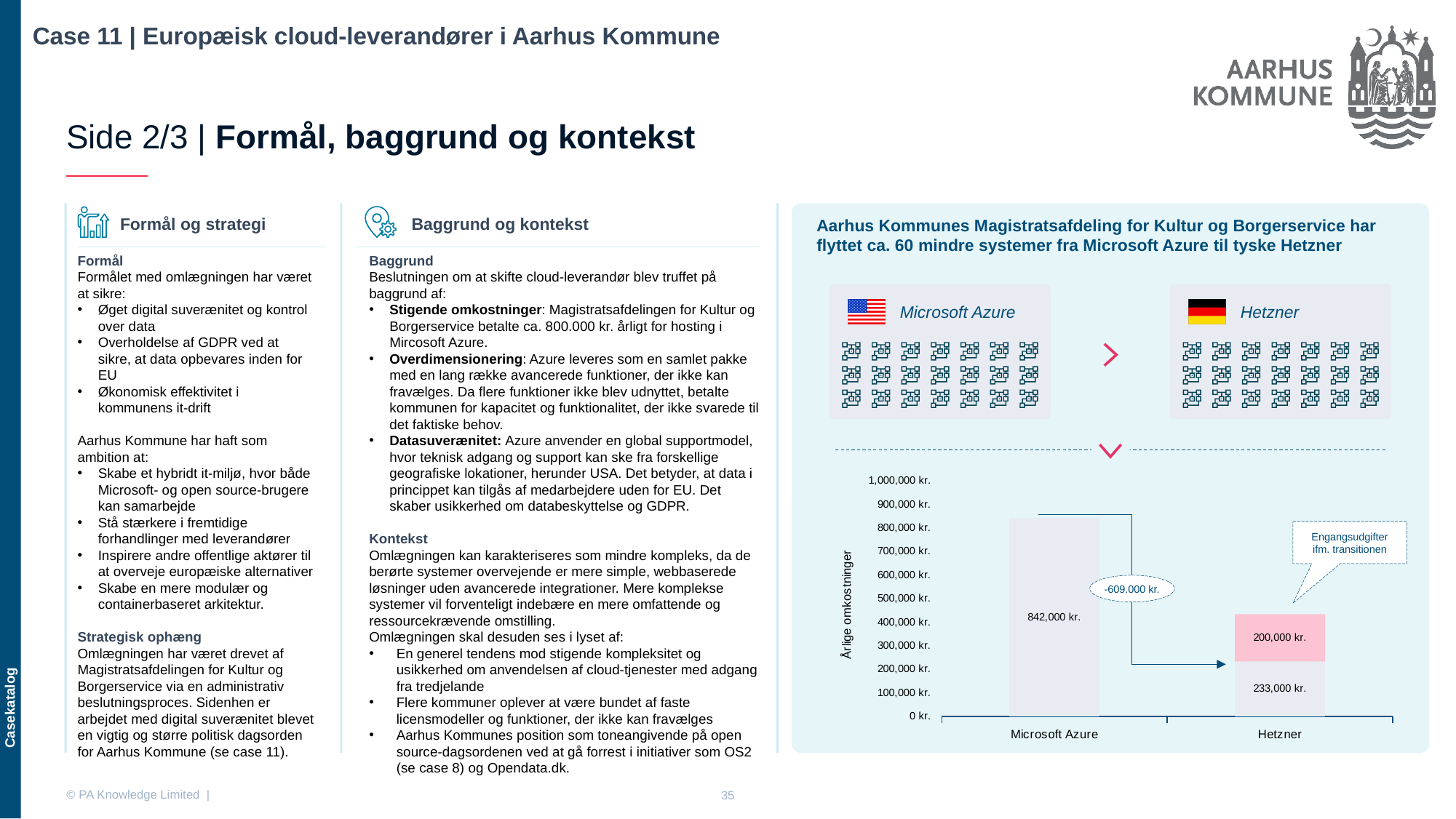
How many categories are shown on the x axis of the bar chart? 2 In the bar chart, what is the annual cost value shown for Microsoft Azure? 842,000 kr. In the bar chart, which category has the highest annual cost? Microsoft Azure In the bar chart, what difference between Microsoft Azure and Hetzner annual costs is printed in the oval annotation? -609.000 kr. In the bar chart, what is the total of the stacked Hetzner bar? 433,000 kr. In the bar chart, which is larger: the Microsoft Azure bar or the total Hetzner bar? Microsoft Azure In the bar chart, what is the value of the lower (annual cost) segment of the Hetzner bar? 233,000 kr. In the bar chart, is the value for Microsoft Azure greater or less than 800,000 kr.? greater What is the label of the y axis of the bar chart? Årlige omkostninger What is the highest tick value shown on the y axis of the bar chart? 1,000,000 kr. In the bar chart, what is the value of the upper segment of the Hetzner bar labelled as one-time transition costs (Engangsudgifter ifm. transitionen)? 200,000 kr. What kind of chart is shown at the bottom right of the slide? bar chart